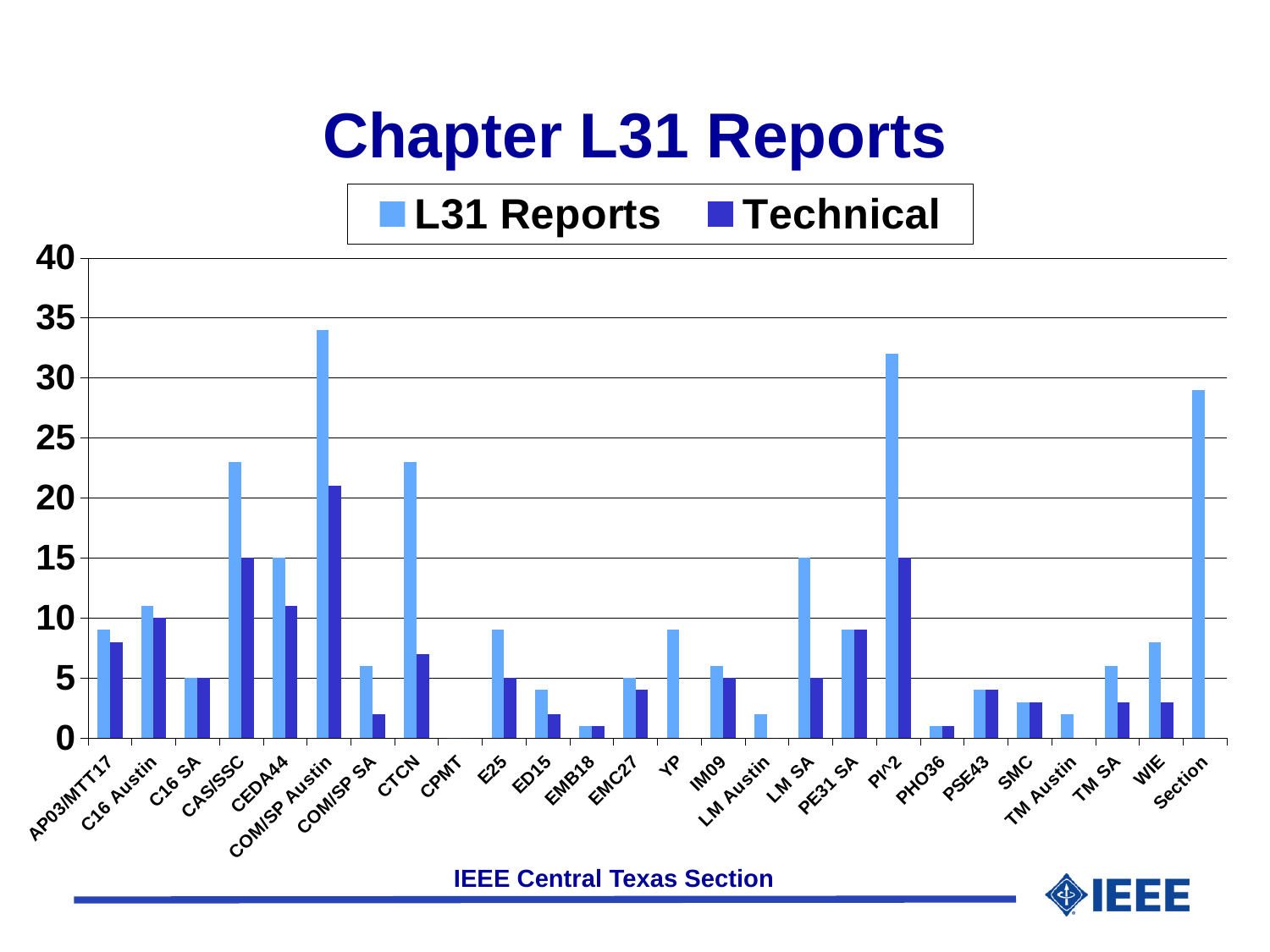
What is the L31 Reports value for LM SA? 15 Which category has the highest Technical value? COM/SP Austin What is the L31 Reports value for CEDA44? 15 Is the L31 Reports value for COM/SP Austin greater or less than 30? greater How many chapter categories are shown along the x axis? 26 How many series does the legend list? 2 For CTCN, which is larger: the L31 Reports value or the Technical value? L31 Reports Is the L31 Reports value for Section greater or less than 25? greater What is the Technical value for CAS/SSC? 15 What is the Technical value for C16 Austin? 10 What are the two series named in the legend? L31 Reports and Technical What kind of chart is shown on the slide? bar chart